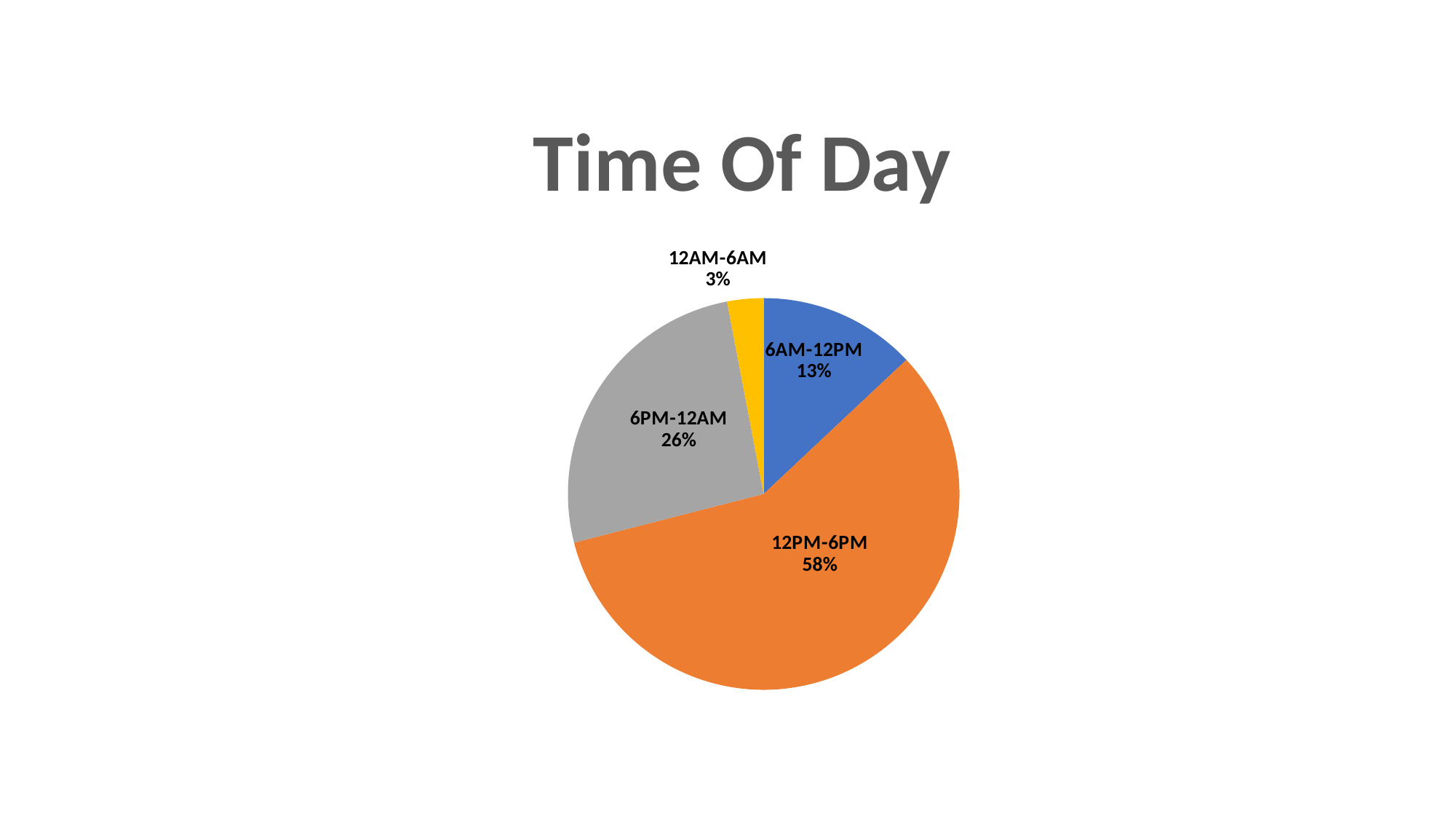
What is the value shown for 12AM-6AM? 3% What share of the pie does 12PM-6PM represent? 58% How many slices does the pie chart have? 4 Which time of day has the largest share? 12PM-6PM What type of chart is shown on the slide? pie chart What is the value shown for 6AM-12PM? 13% Which is larger, the share for 6AM-12PM or the share for 6PM-12AM? 6PM-12AM What is the difference between the shares for 12PM-6PM and 6PM-12AM? 32% What colour is the 12PM-6PM slice? orange What is the value shown for 6PM-12AM? 26% What is the title of the chart? Time Of Day Which time of day has the smallest share? 12AM-6AM